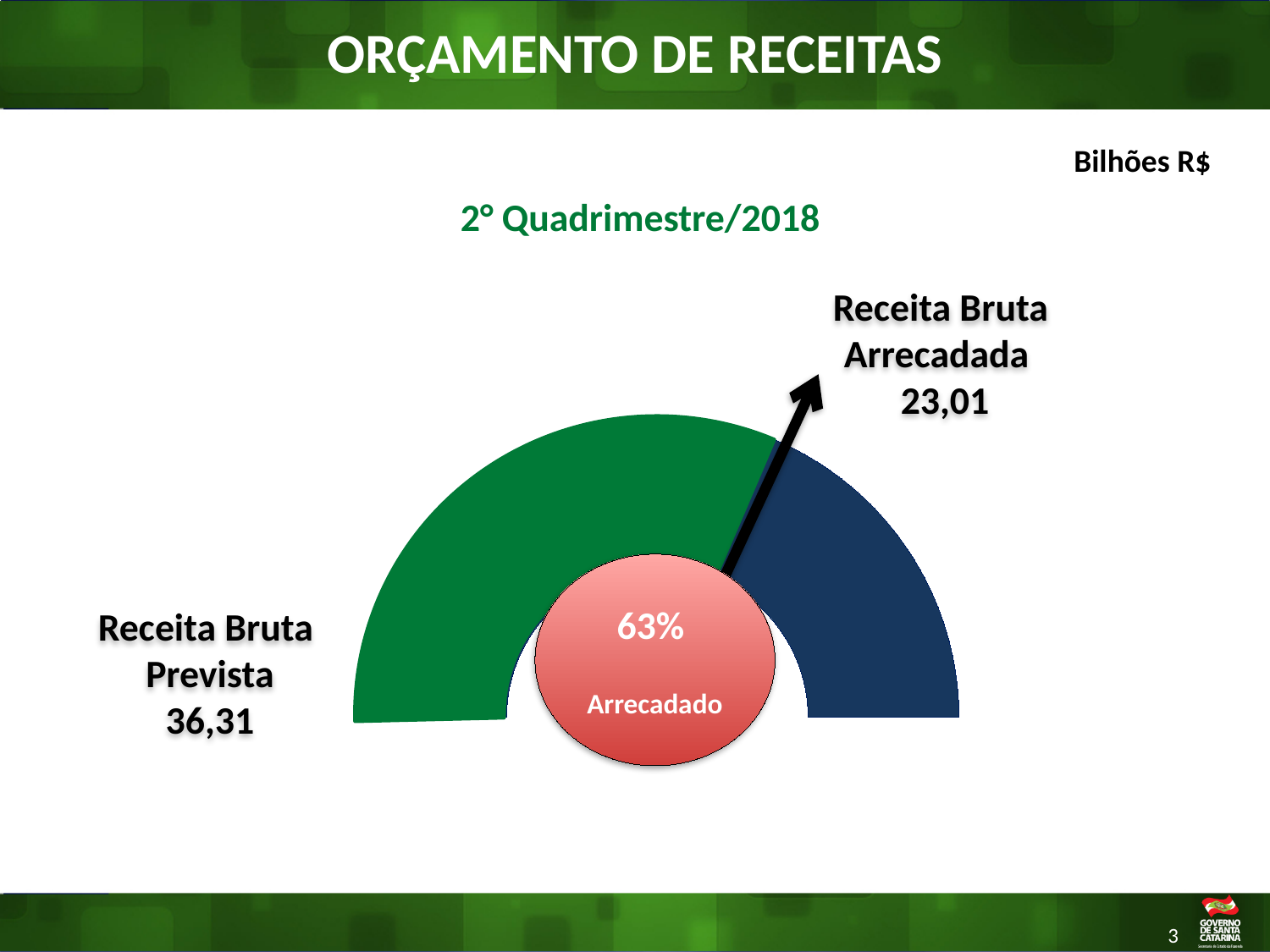
What is the value shown for Receita Bruta Arrecadada? 23,01 In what unit are the values on the slide expressed? Bilhões R$ What kind of chart is shown on the slide? Gauge chart Which is larger, Receita Bruta Prevista or Receita Bruta Arrecadada? Receita Bruta Prevista What is the difference between Receita Bruta Prevista and Receita Bruta Arrecadada? 13,30 Which period does the chart refer to? 2º Quadrimestre/2018 What is the value shown for Receita Bruta Prevista? 36,31 What percentage is shown as Arrecadado in the centre of the gauge? 63% Is the value for Receita Bruta Arrecadada greater or less than 30? less